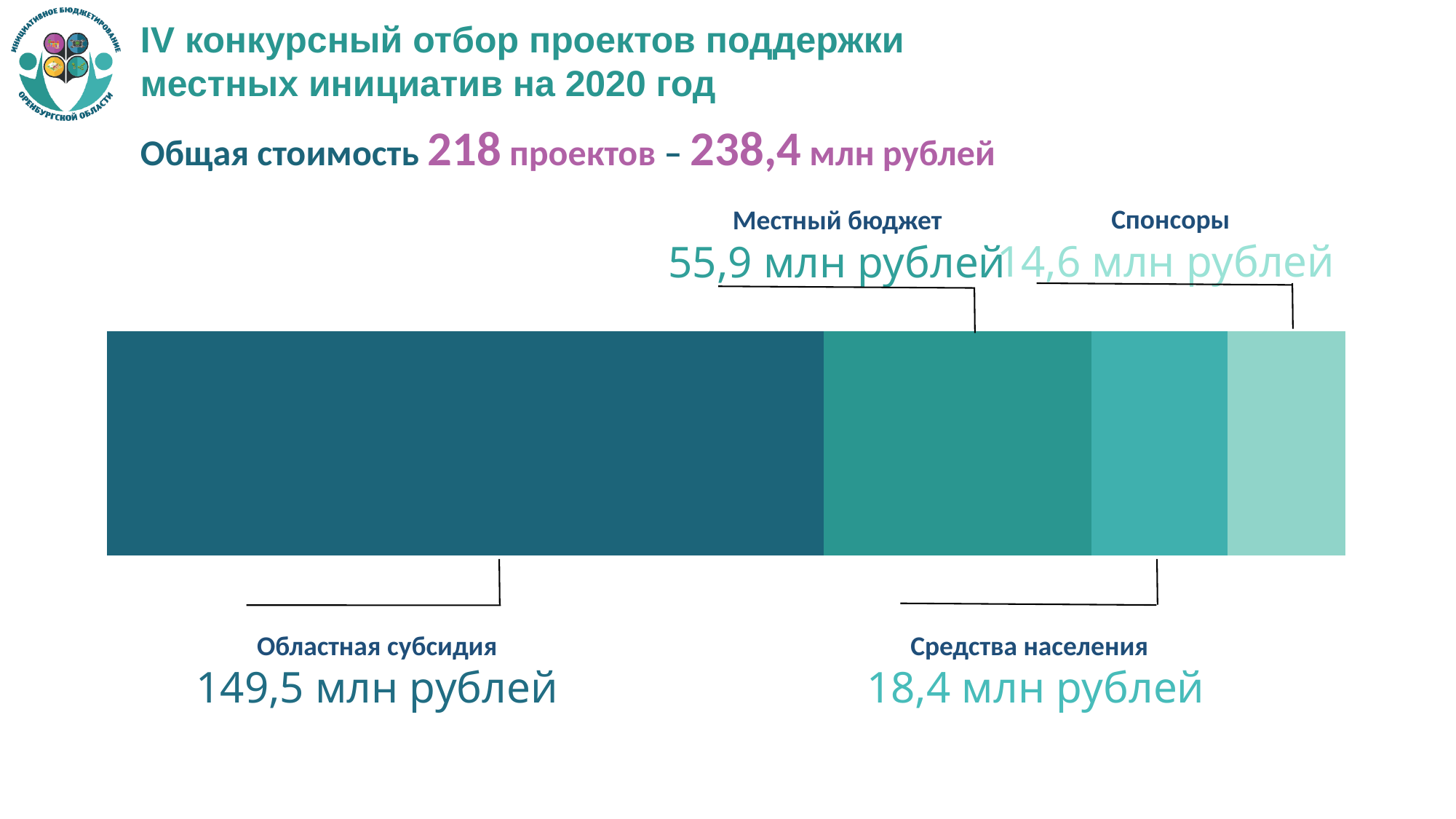
Which is larger, Местный бюджет or Средства населения? Местный бюджет What is the total of all segments in the stacked bar? 238,4 млн рублей What kind of chart is shown on the slide? Stacked bar chart What is the value for Местный бюджет? 55,9 млн рублей What is the value for Областная субсидия? 149,5 млн рублей What is the difference between Областная субсидия and Местный бюджет? 93,6 млн рублей Which funding source has the largest segment in the bar? Областная субсидия What is the difference between Средства населения and Спонсоры? 3,8 млн рублей What is the value for Спонсоры? 14,6 млн рублей Which funding source has the smallest segment in the bar? Спонсоры How many segments make up the stacked bar? 4 What is the value for Средства населения? 18,4 млн рублей